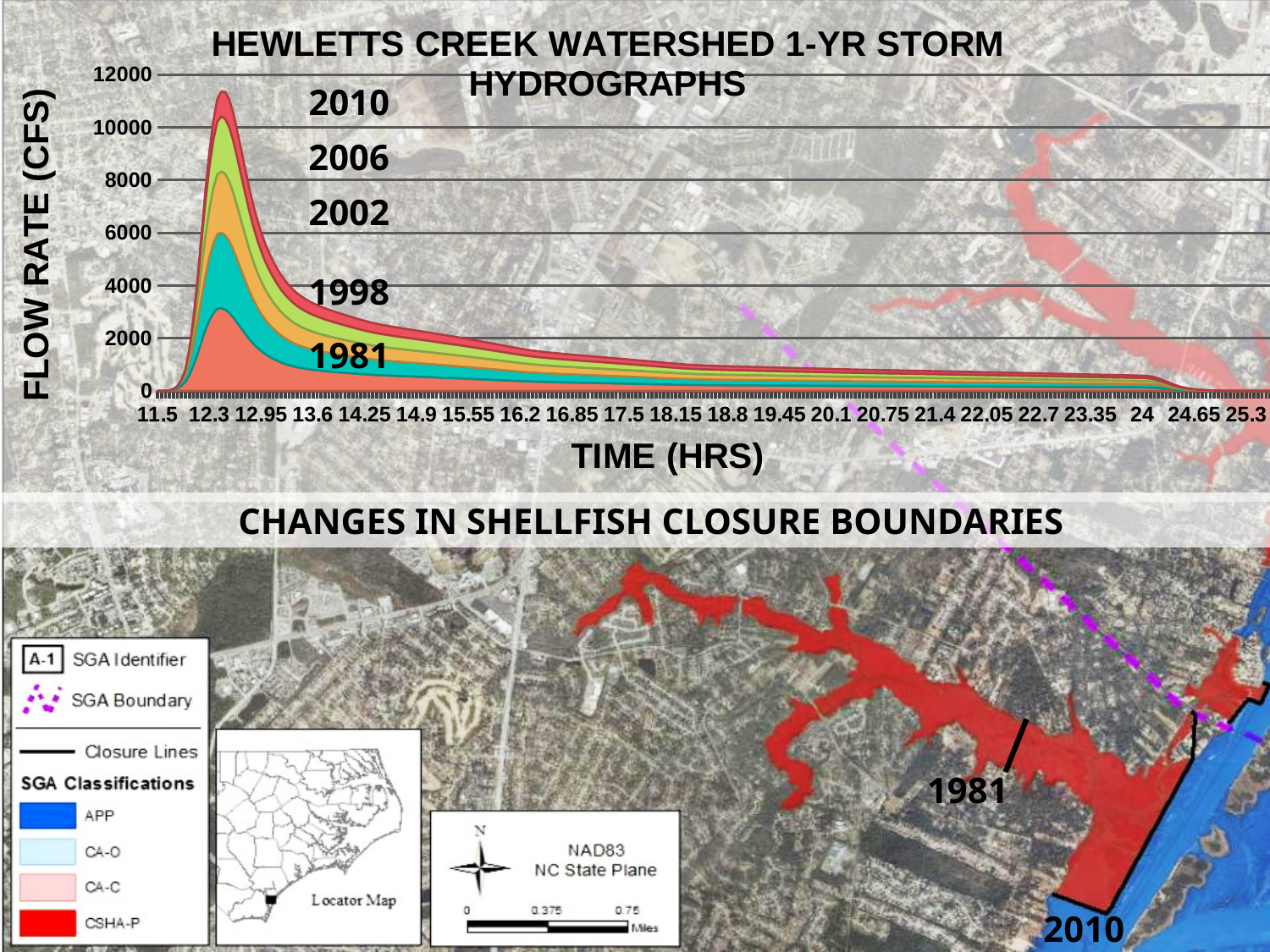
Is the peak of the 1981 layer in the hydrograph chart greater or less than 4000 CFS? less Which year forms the top layer of the stacked hydrograph chart? 2010 Is the peak of the top of the stacked hydrograph (2010 layer) greater or less than 10000 CFS? greater Is the peak of the 1981 layer in the hydrograph chart greater or less than 2000 CFS? greater Which year forms the bottom layer of the stacked hydrograph chart? 1981 How many years (series) are plotted in the hydrograph chart? 5 What is the first time value shown on the horizontal axis of the hydrograph chart? 11.5 What kind of chart is shown on the slide? Stacked area chart What is the highest value shown on the flow rate axis of the hydrograph chart? 12000 What is the label of the vertical axis of the hydrograph chart? FLOW RATE (CFS) What is the title of the chart on the slide? HEWLETTS CREEK WATERSHED 1-YR STORM HYDROGRAPHS After the peak near 12.3 hours, does the flow rate in the hydrograph chart rise or fall as time increases? fall